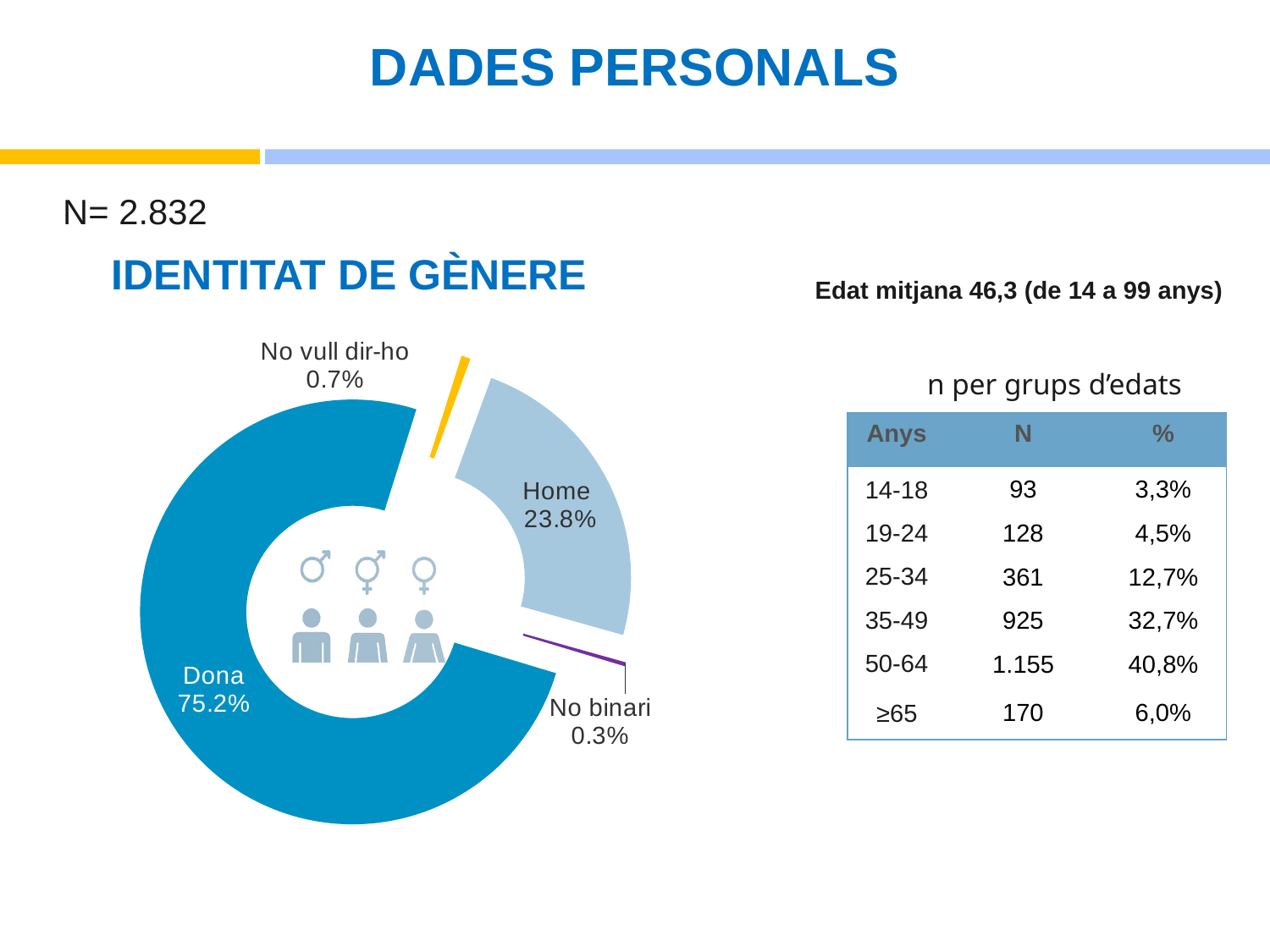
What is the title of the chart on the left of the slide? IDENTITAT DE GÈNERE What percentage of the IDENTITAT DE GÈNERE chart is Home? 23.8% What kind of chart is the IDENTITAT DE GÈNERE chart? Donut (pie) chart Which category has the smallest share in the IDENTITAT DE GÈNERE chart? No binari How many categories are shown in the IDENTITAT DE GÈNERE chart? 4 What percentage does the No binari slice represent in the IDENTITAT DE GÈNERE chart? 0.3% What percentage does the No vull dir-ho slice represent in the IDENTITAT DE GÈNERE chart? 0.7% What colour is the Dona slice in the IDENTITAT DE GÈNERE chart? Blue Which category has the largest share in the IDENTITAT DE GÈNERE chart? Dona What is the difference in percentage points between Dona and Home in the IDENTITAT DE GÈNERE chart? 51.4 What percentage of the IDENTITAT DE GÈNERE chart is Dona? 75.2% In the IDENTITAT DE GÈNERE chart, which is larger, No vull dir-ho or No binari? No vull dir-ho